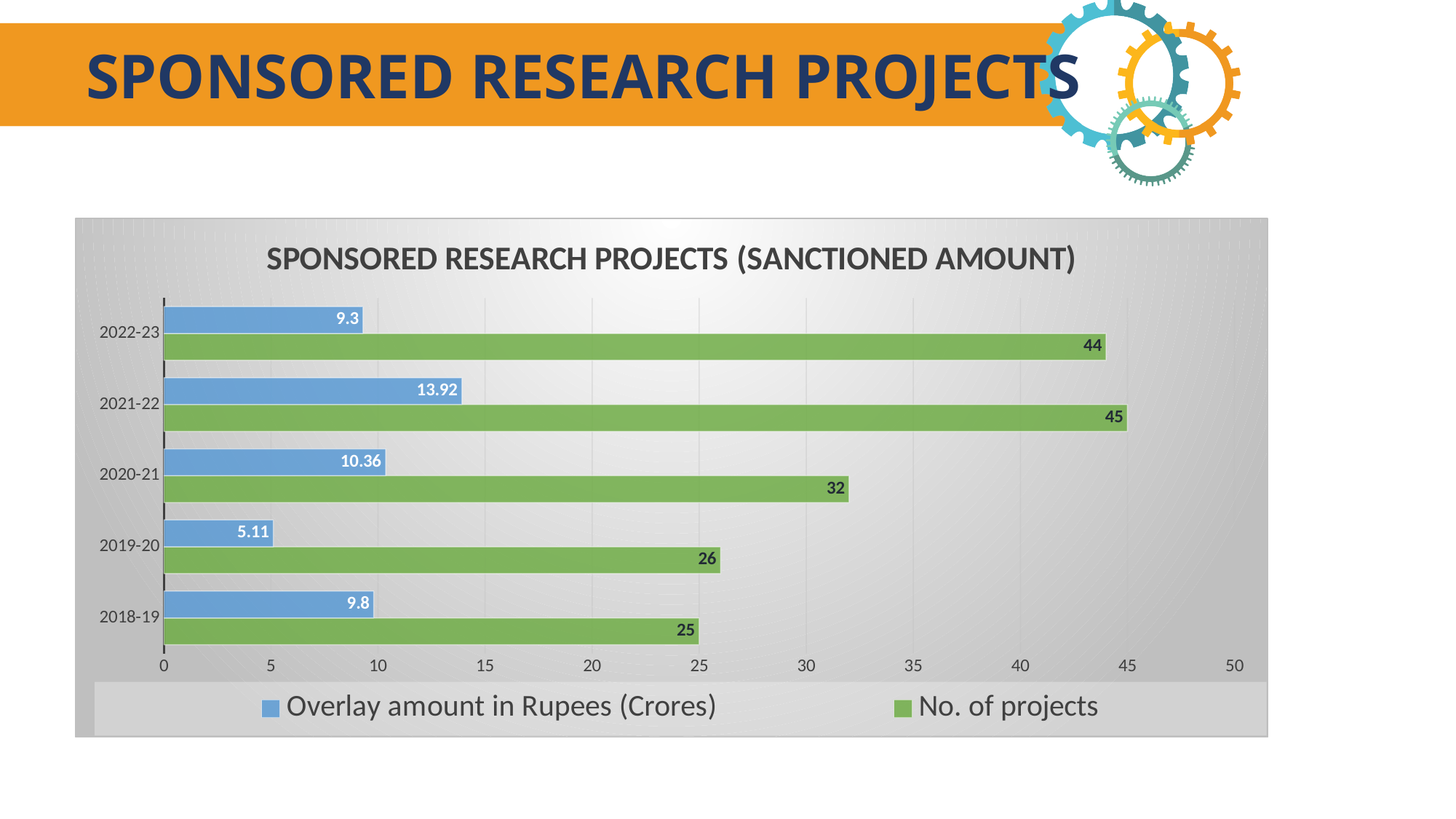
Which year has the highest number of projects? 2021-22 Which year has the lowest overlay amount in Rupees (Crores)? 2019-20 What is the overlay amount in Rupees (Crores) for 2021-22? 13.92 How many years are shown on the chart? 5 What is the overlay amount in Rupees (Crores) for 2019-20? 5.11 What is the difference in the number of projects between 2021-22 and 2018-19? 20 How many series does the legend list? 2 What kind of chart is shown on the slide? Bar chart Which colour represents the No. of projects series? Green Which year has a larger overlay amount in Rupees (Crores), 2020-21 or 2018-19? 2020-21 What is the title of the chart? SPONSORED RESEARCH PROJECTS (SANCTIONED AMOUNT) What is the number of projects for 2022-23? 44